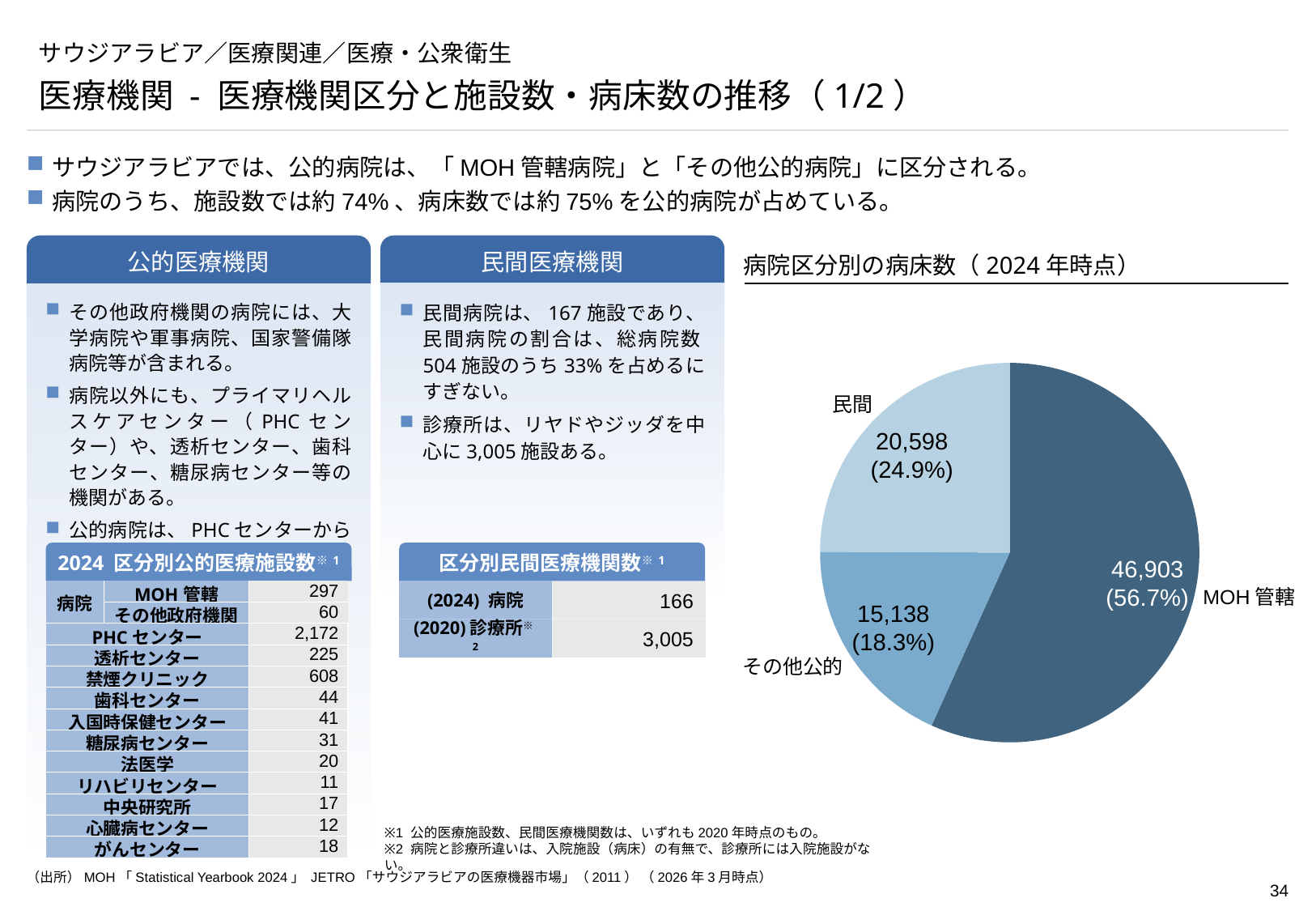
How many beds does the 民間 slice represent? 20,598 What share of the pie does the MOH管轄 slice account for? 56.7% Which has more beds, 民間 or その他公的? 民間 What is the title of the chart on the slide? 病院区分別の病床数（2024年時点） Which category has the largest number of beds in the pie chart? MOH管轄 How many beds does the MOH管轄 slice represent? 46,903 How many beds does the その他公的 slice represent? 15,138 What type of chart is shown on the slide? pie chart How many slices does the pie chart have? 3 Which category has the smallest number of beds in the pie chart? その他公的 What is the difference in beds between MOH管轄 and 民間? 26,305 What share of the pie does the その他公的 slice account for? 18.3%